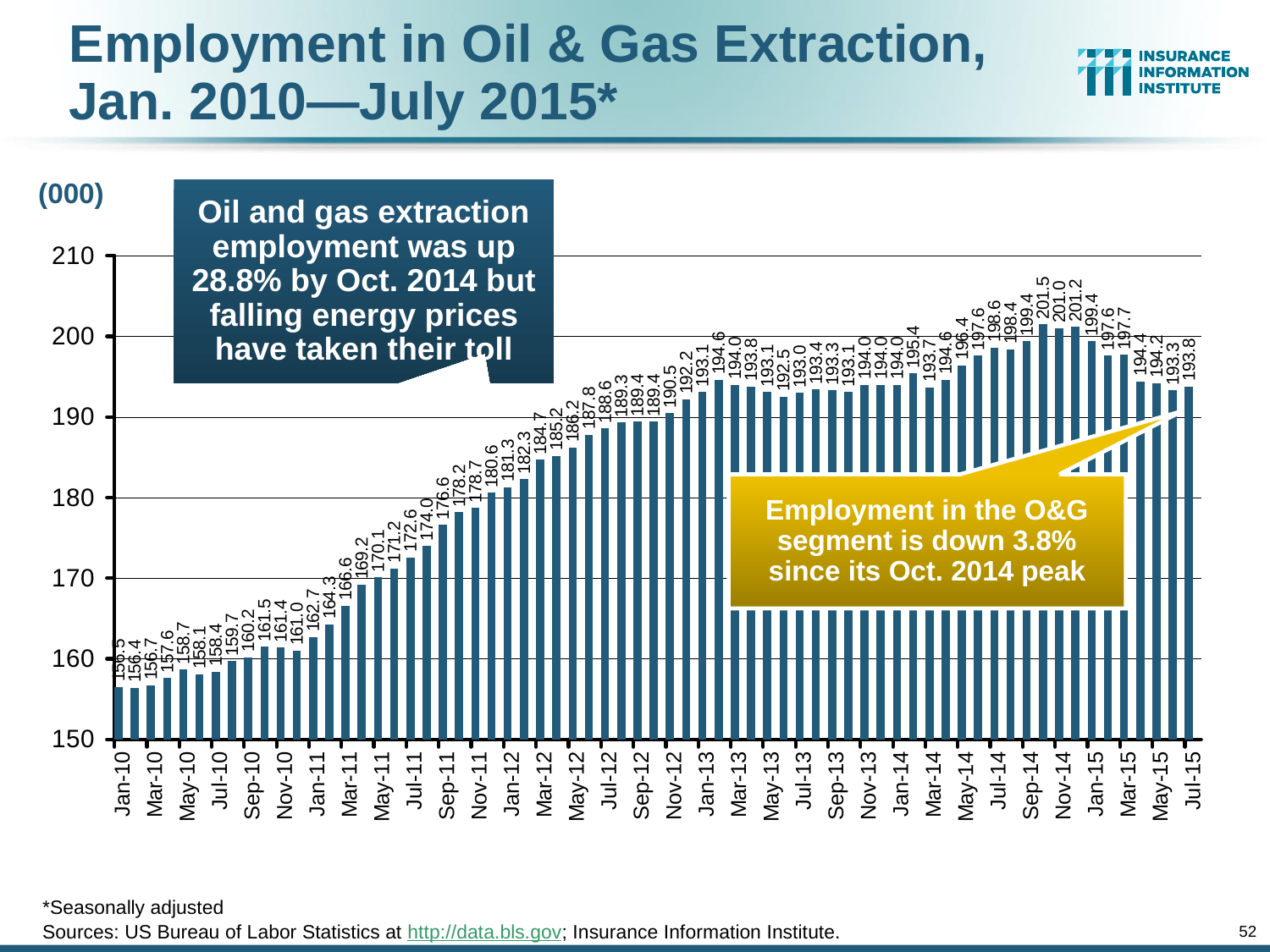
Which month had higher oil and gas extraction employment, Jan-15 or Jul-15? Jan-15 What type of chart is shown on the slide? Bar chart What is the overall trend in employment from Jan-10 to Oct-14? Rising What was oil and gas extraction employment (000) in Jan-13? 193.1 What was oil and gas extraction employment (000) in Jul-15? 193.8 What was oil and gas extraction employment (000) in Jan-10? 156.5 What was oil and gas extraction employment (000) in Jan-15? 199.4 Is the value for Jul-11 greater or less than 170? greater In which month did oil and gas extraction employment reach its peak, and what was the value? Oct. 2014, 201.5 According to the annotation, by what percentage is employment in the O&G segment down since its Oct. 2014 peak? 3.8% By how much (000) did oil and gas extraction employment change from Jan-10 to Jul-15? 37.3 What is the difference (000) between employment in Jan-15 and Jul-15? 5.6